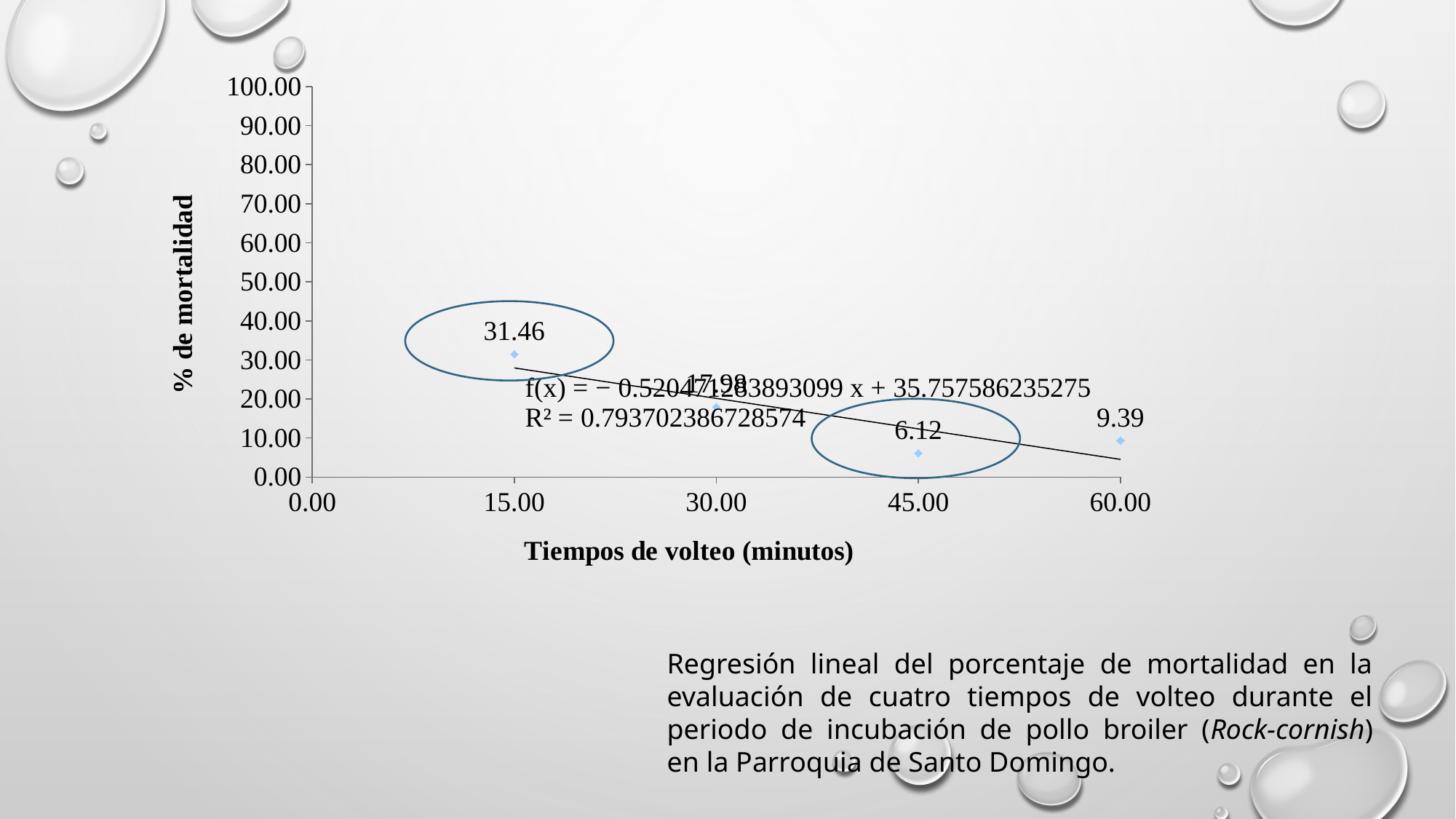
How many data points are plotted on the chart? 4 What is the title of the x axis of the chart? Tiempos de volteo (minutos) What is the % de mortalidad value at a tiempo de volteo of 45.00 minutes? 6.12 Is the % de mortalidad value at 30.00 minutes greater or less than 10.00? greater What is the difference in % de mortalidad between the 15.00-minute and 45.00-minute points? 25.34 At which tiempo de volteo is the % de mortalidad lowest? 45.00 At which tiempo de volteo is the % de mortalidad highest? 15.00 What is the % de mortalidad value at a tiempo de volteo of 15.00 minutes? 31.46 What is the difference in % de mortalidad between the 60.00-minute and 45.00-minute points? 3.27 Which has a higher % de mortalidad: the 45.00-minute point or the 60.00-minute point? 60.00 What is the % de mortalidad value at a tiempo de volteo of 60.00 minutes? 9.39 What kind of chart is shown on the slide? scatter chart